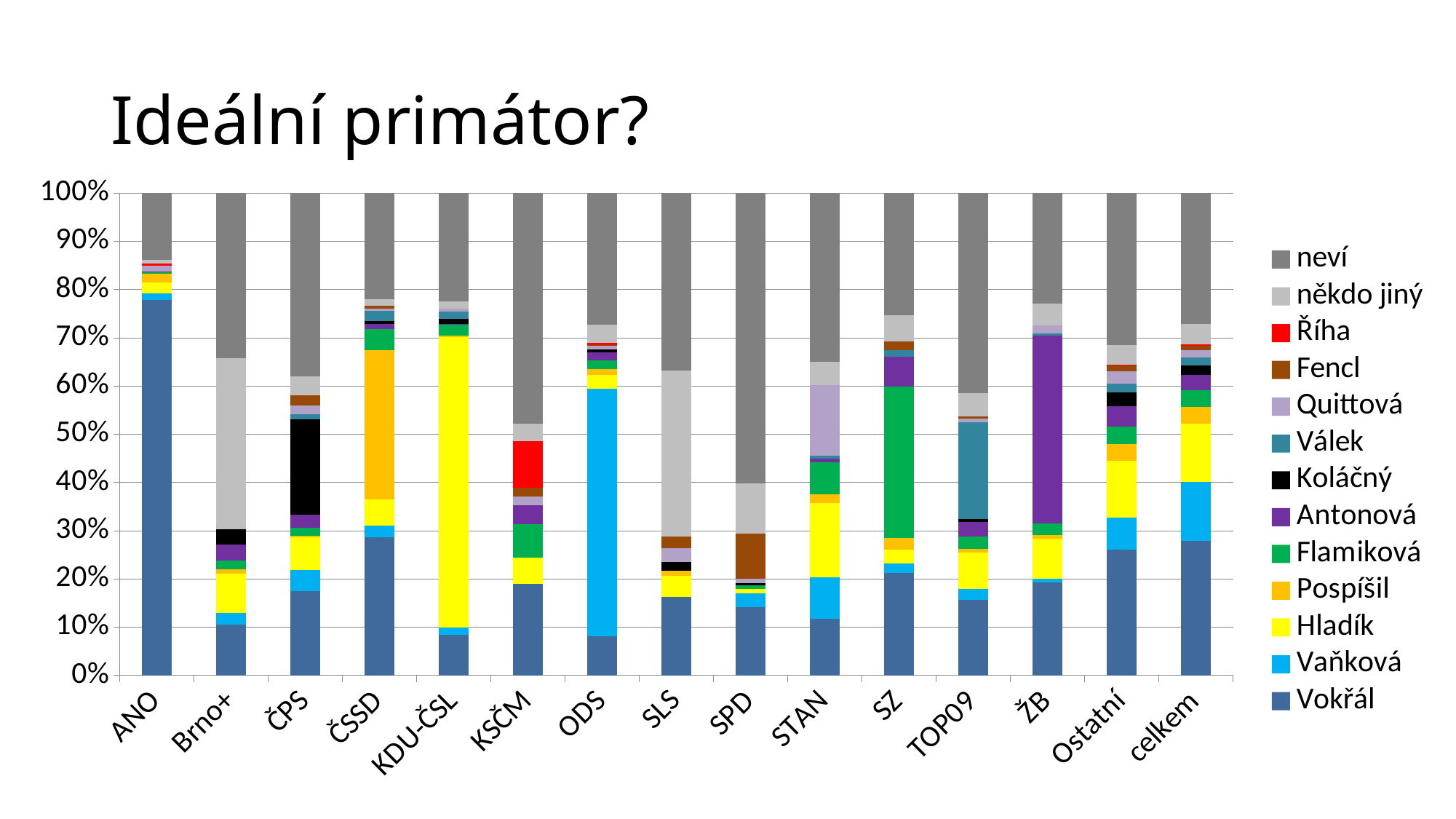
Is the Vokřál share for ANO greater or less than 70%? greater What type of chart is shown on the slide? stacked bar chart Which category has the smallest neví segment? ANO How many categories are shown on the x axis of the chart? 15 Which category has the largest Vokřál segment? ANO Is the Hladík share for KDU-ČSL greater or less than 50%? greater What is the title of the chart? Ideální primátor? What does each stacked bar total? 100% Which category has the largest neví segment? SPD Which is larger, the Vokřál share for ANO or for Brno+? ANO How many series does the legend list? 13 Is the Vokřál share for ODS greater or less than 10%? less